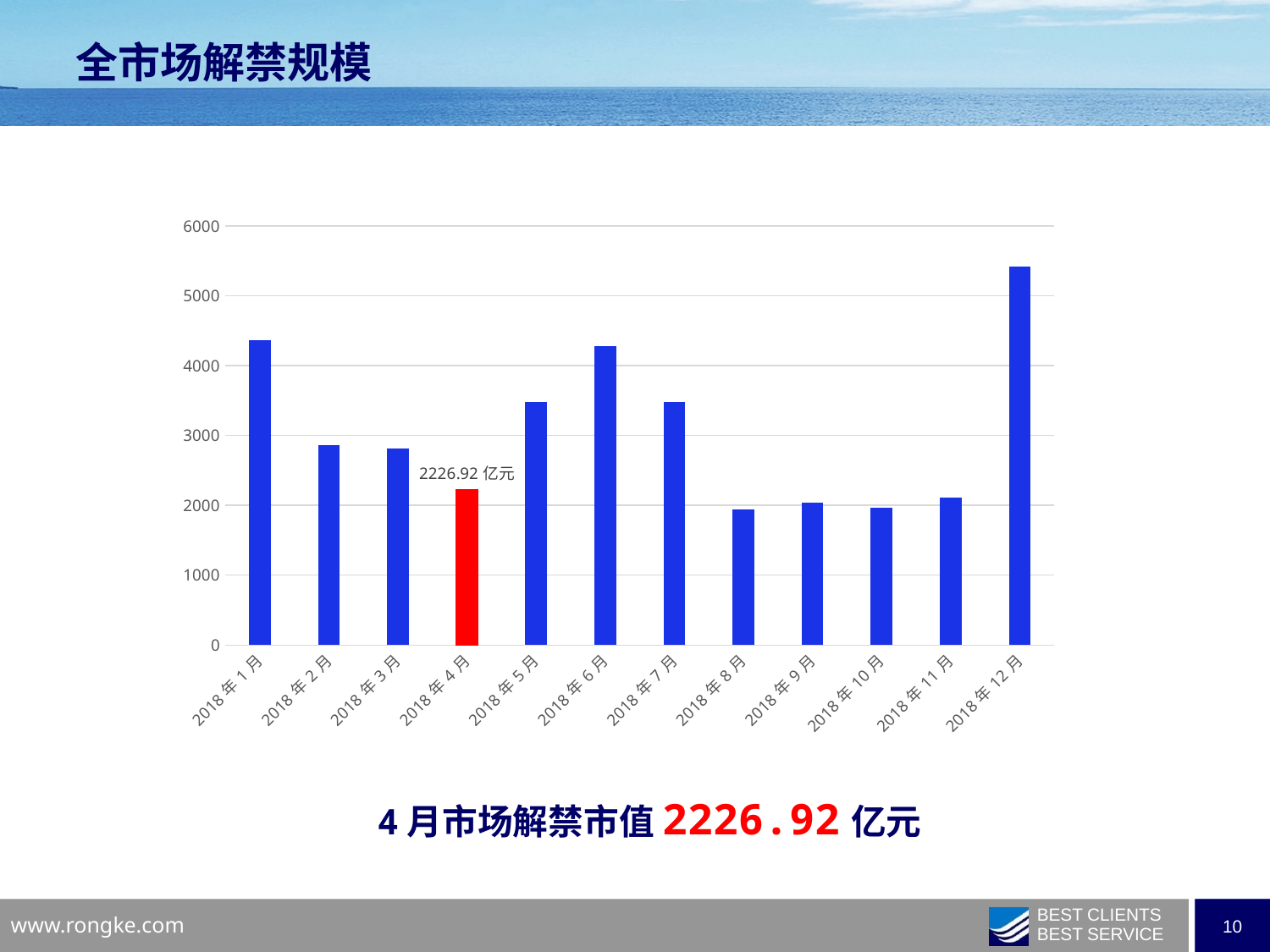
Is the value for 2018年1月 greater or less than 4000? greater Is the value for 2018年3月 greater or less than 3000? less Which is larger, the value for 2018年2月 or 2018年4月? 2018年2月 Is the value for 2018年8月 greater or less than 2000? less Which month's bar is coloured red? 2018年4月 What kind of chart is shown on the slide? bar chart Which is larger, the value for 2018年12月 or 2018年1月? 2018年12月 Which month has the highest bar? 2018年12月 How many months are shown on the x axis? 12 What is the value shown for 2018年4月? 2226.92 亿元